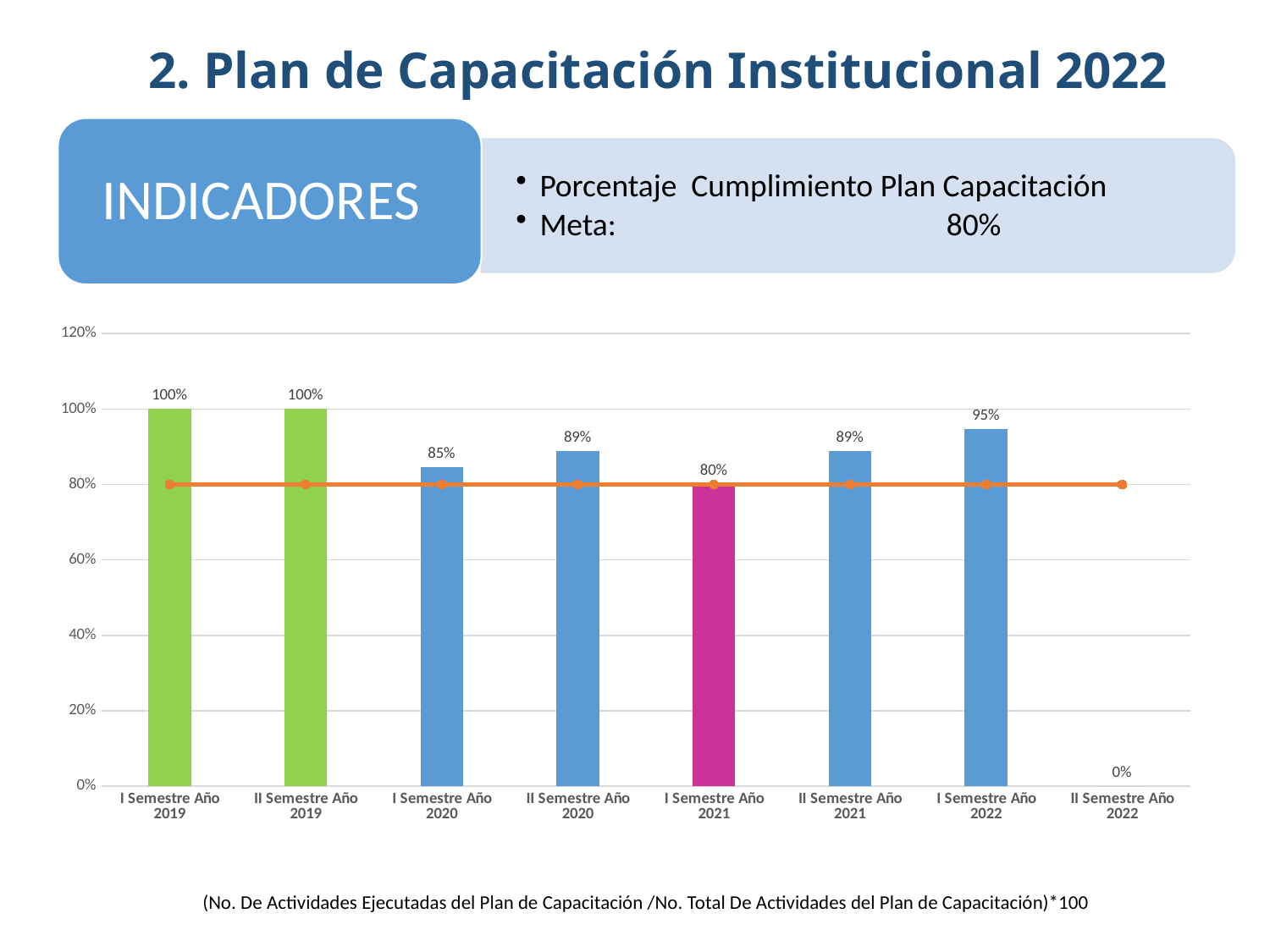
What is the value for II Semestre Año 2022? 0% At what value does the horizontal orange line run across the chart? 80% What kind of chart is shown on the slide? Combination bar and line chart How many categories are shown on the x axis? 8 What is the value for I Semestre Año 2021? 80% What is the value for I Semestre Año 2020? 85% Which category has the lowest value? II Semestre Año 2022 Do the bar values rise or fall from I Semestre Año 2021 to I Semestre Año 2022? Rise Which is larger, the value for I Semestre Año 2022 or the value for II Semestre Año 2021? I Semestre Año 2022 What is the value for I Semestre Año 2022? 95% What is the difference between the values for I Semestre Año 2022 and I Semestre Año 2020? 10% What is the difference between the values for II Semestre Año 2019 and I Semestre Año 2021? 20%